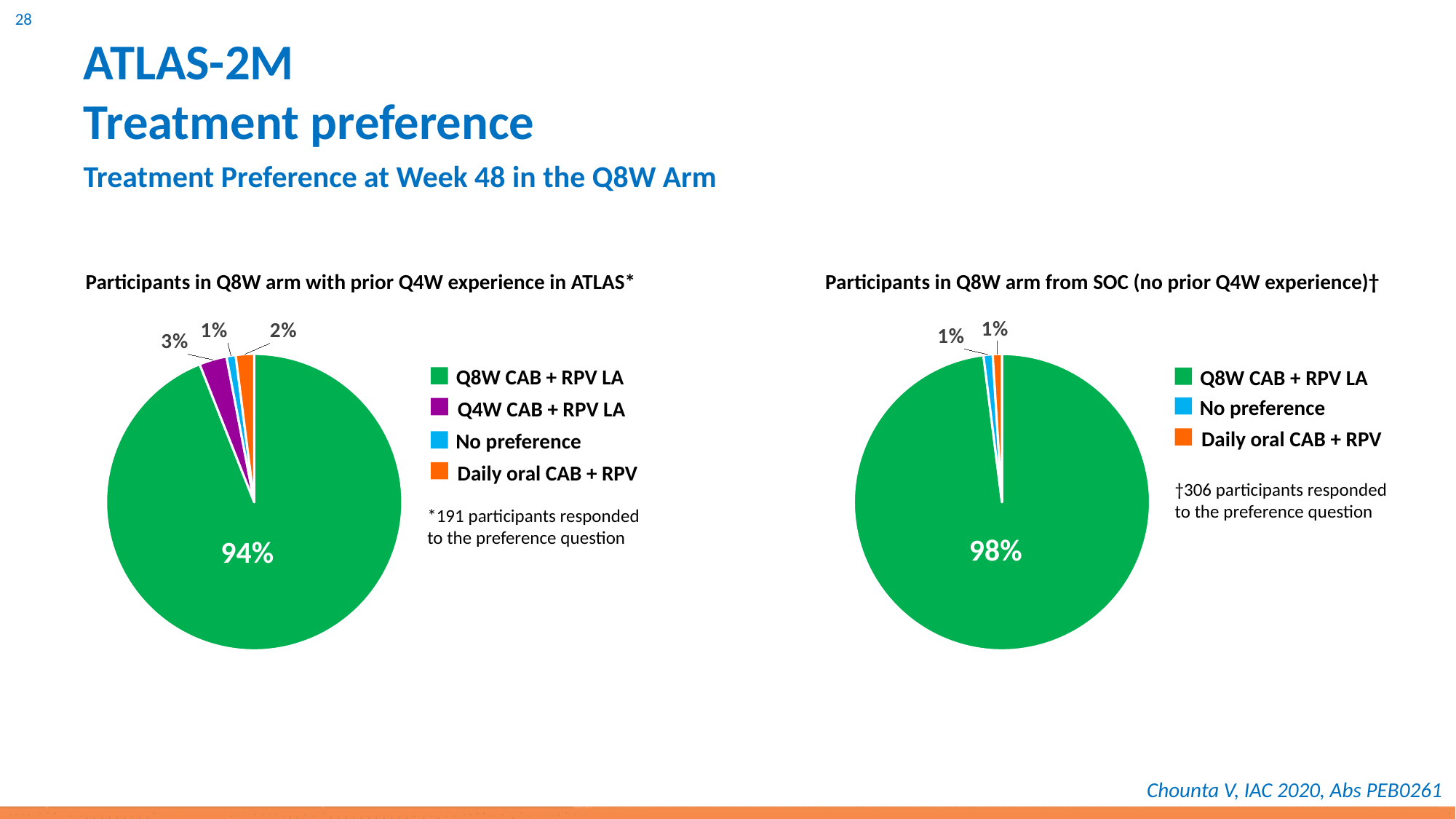
In the left pie chart (prior Q4W experience in ATLAS), what share of participants had no preference? 1% In the right pie chart (from SOC, no prior Q4W experience), what share of participants preferred daily oral CAB + RPV? 1% In the right pie chart (from SOC, no prior Q4W experience), what share of participants preferred Q8W CAB + RPV LA? 98% In the left pie chart (prior Q4W experience in ATLAS), which category has the smallest slice? No preference What is the difference between the Q8W CAB + RPV LA share in the right pie chart and the Q8W CAB + RPV LA share in the left pie chart? 4% How many categories does the legend of the left pie chart (prior Q4W experience in ATLAS) list? 4 In the left pie chart (prior Q4W experience in ATLAS), which category has the largest slice? Q8W CAB + RPV LA How many categories does the legend of the right pie chart (from SOC, no prior Q4W experience) list? 3 What type of chart is used on this slide to show treatment preference? Pie chart